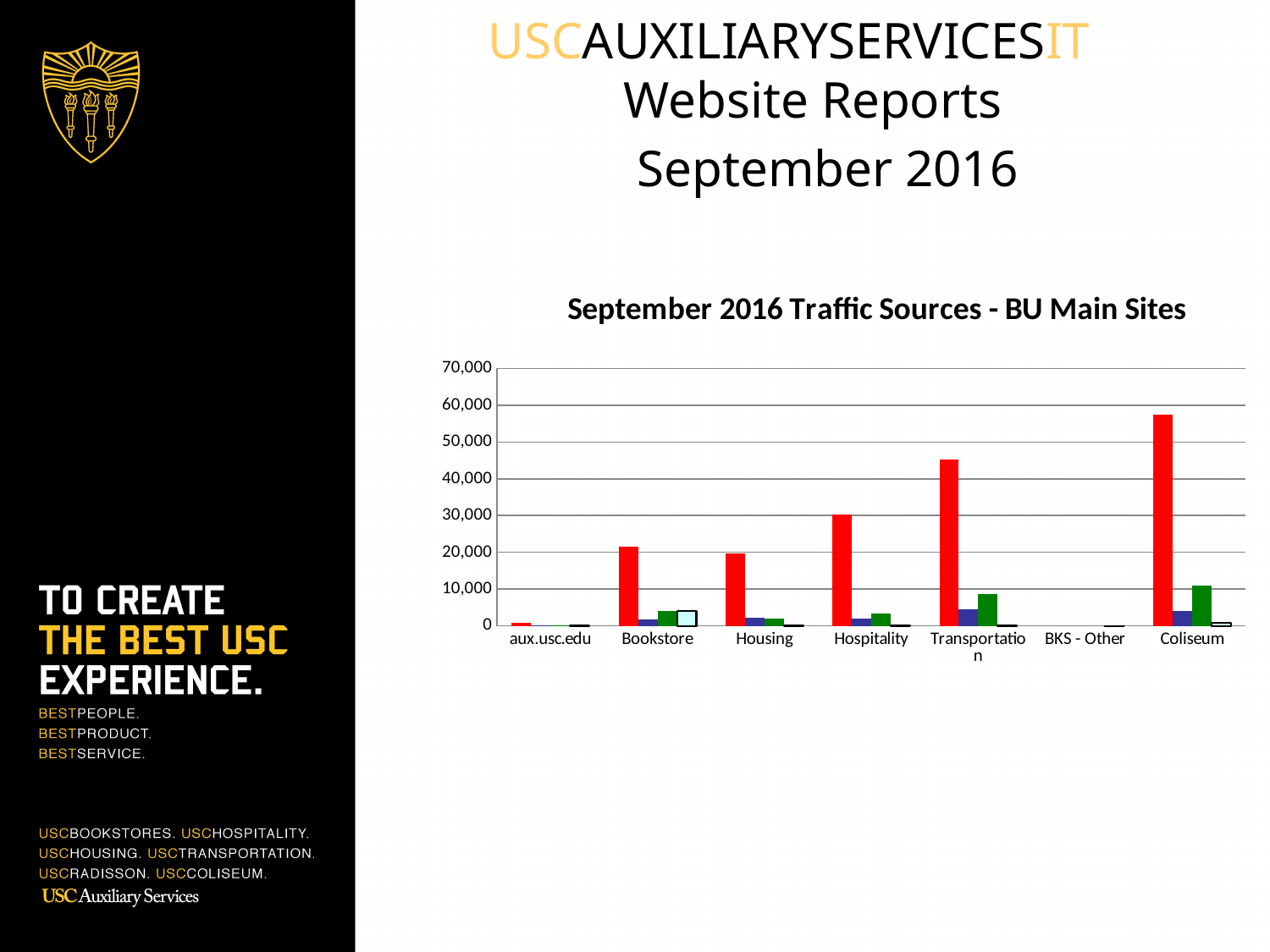
Is the red bar for Transportation greater or less than 50,000? less Which has the larger red bar, Transportation or Hospitality? Transportation How many categories are shown along the x axis of the chart? 7 What is the title of the chart? September 2016 Traffic Sources - BU Main Sites Which category has the tallest red bar? Coliseum Is the red bar for Housing greater or less than 10,000? greater Is the red bar for Coliseum greater or less than 50,000? greater What kind of chart is shown on the slide? bar chart Which category has the smallest red bar? BKS - Other Which has the larger green bar, Coliseum or Housing? Coliseum